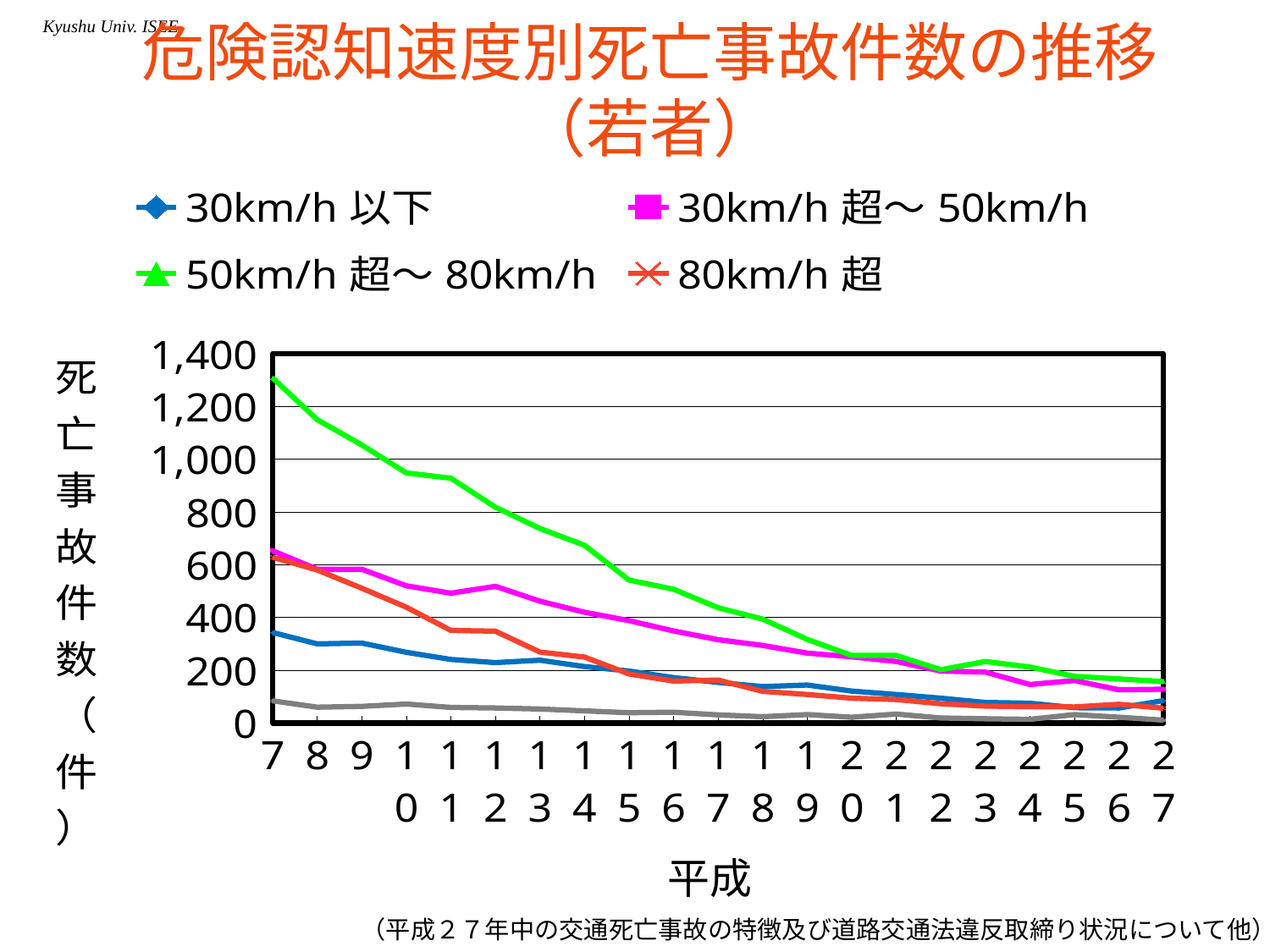
Is the value for 50km/h 超～ 80km/h at 平成7 greater or less than 1,200? greater Which series has the highest value at 平成7? 50km/h 超～ 80km/h Is the value for 50km/h 超～ 80km/h at 平成12 greater or less than 600? greater Is the value for 30km/h 以下 at 平成7 greater or less than 400? less At 平成7, which is larger: 30km/h 超～ 50km/h or 30km/h 以下? 30km/h 超～ 50km/h Does the 80km/h 超 series rise or fall from 平成7 to 平成27? fall How many series does the legend list? 4 How many years (x-axis points) are plotted, from 平成7 to 平成27? 21 What is the label of the x axis? 平成 Does the 50km/h 超～ 80km/h series rise or fall from 平成7 to 平成27? fall What kind of chart is shown on the slide? line chart